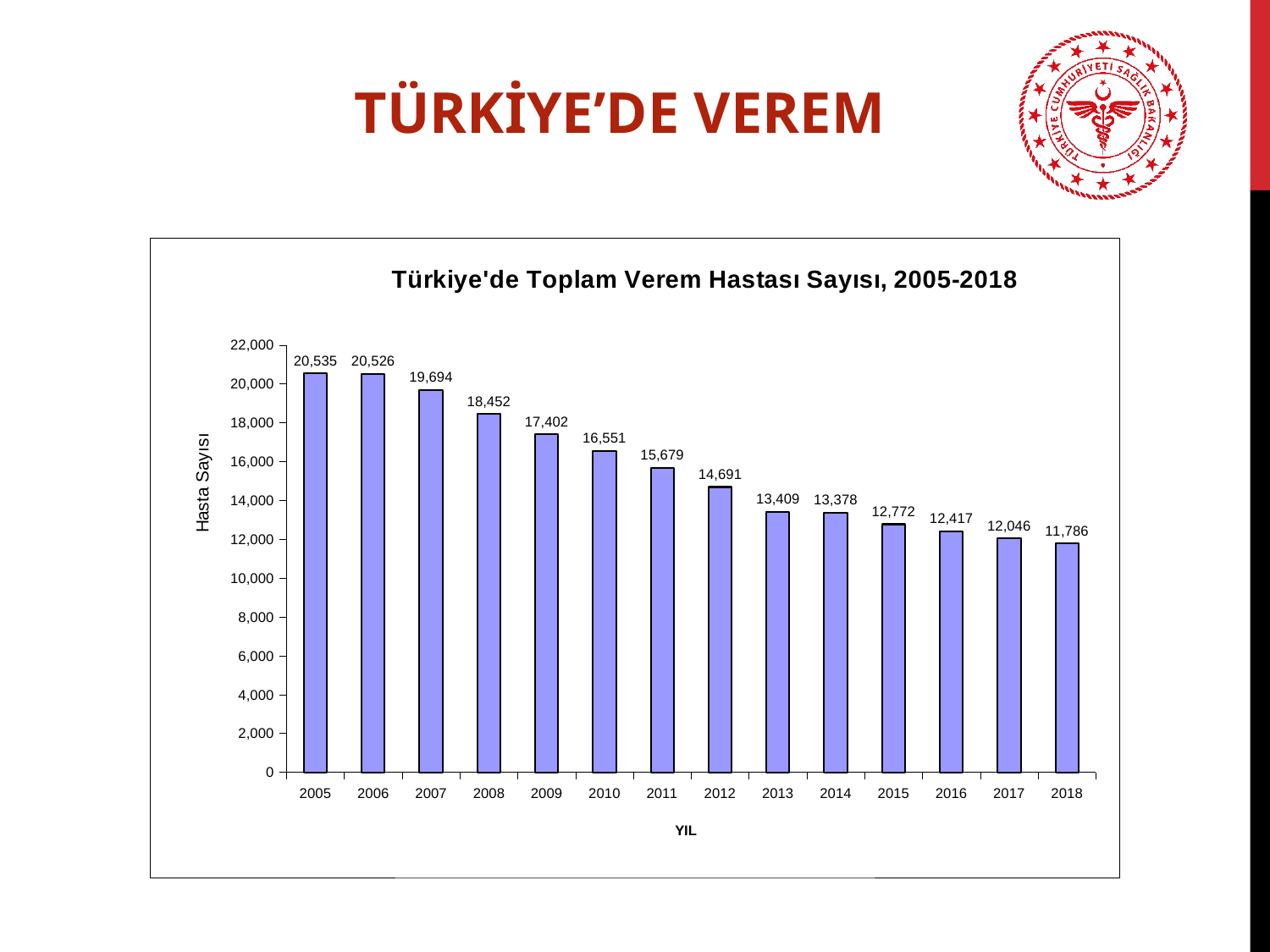
Do the values rise or fall from 2005 to 2018? fall What is the difference between the values for 2005 and 2018? 8,749 What is the number of tuberculosis patients in 2005? 20,535 How many years are shown on the x axis? 14 Which year has the lowest number of patients? 2018 What is the difference between the values for 2009 and 2010? 851 What is the value shown for 2012? 14,691 What kind of chart is shown on the slide? bar chart What is the title of the chart? Türkiye'de Toplam Verem Hastası Sayısı, 2005-2018 What is the value shown for 2018? 11,786 Which is larger, the value for 2013 or the value for 2014? 2013 Is the value for 2008 greater or less than 18,000? greater